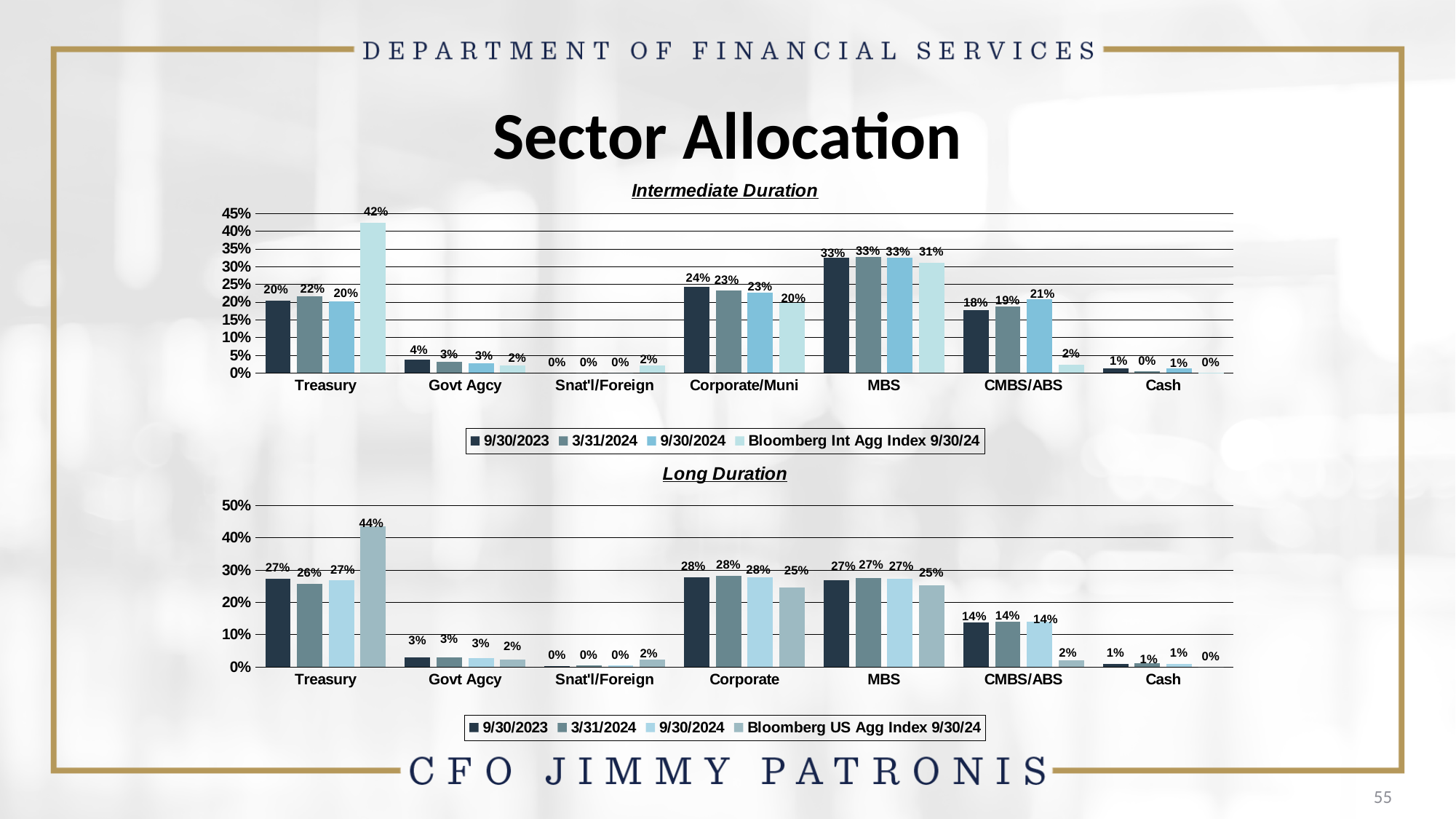
In the Long Duration chart, what is the value for CMBS/ABS on 3/31/2024? 14% In the Intermediate Duration chart, which category has the lowest value for the Bloomberg Int Agg Index 9/30/24 series? Cash How many categories are shown on the x axis of the Long Duration chart? 7 In the Intermediate Duration chart, what is the value for Treasury in the Bloomberg Int Agg Index 9/30/24 series? 42% What type of chart is the Long Duration chart? Bar chart In the Long Duration chart, which is larger for the 9/30/2024 series: Corporate or MBS? Corporate In the Intermediate Duration chart, which category has the highest value for the 9/30/2023 series? MBS In the Intermediate Duration chart, how many series does the legend list? 4 In the Intermediate Duration chart, what is the difference between the Corporate/Muni value on 9/30/2023 and on 9/30/2024? 1% In the Long Duration chart, what is the value for Treasury in the Bloomberg US Agg Index 9/30/24 series? 44% In the Intermediate Duration chart, what is the value for CMBS/ABS on 9/30/2024? 21% In the Long Duration chart, what is the difference between the Treasury value for the Bloomberg US Agg Index 9/30/24 and the Treasury value on 9/30/2024? 17%